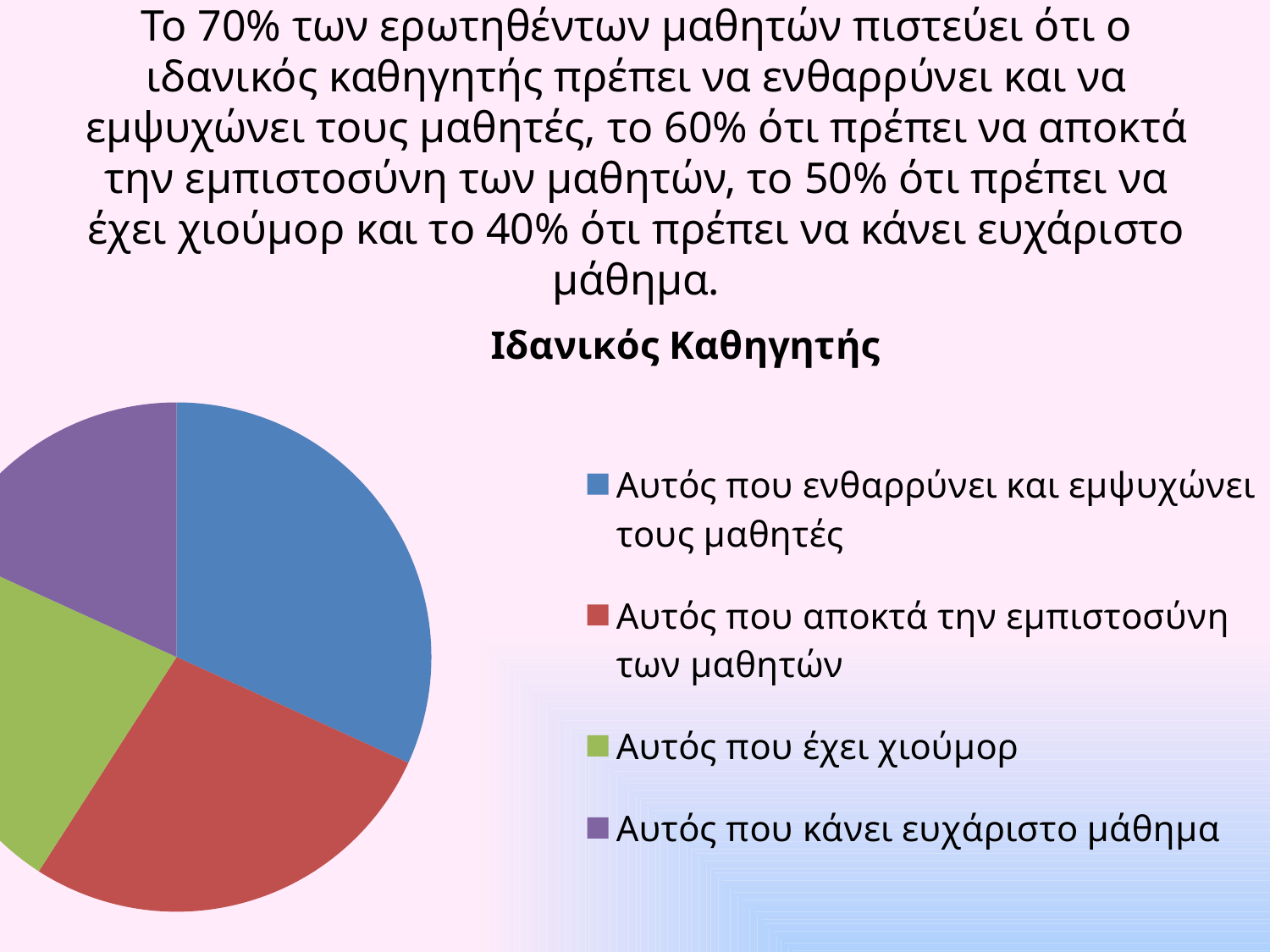
What is the title of the chart? Ιδανικός Καθηγητής How many entries does the legend list? 4 Which category has the largest slice of the pie? Αυτός που ενθαρρύνει και εμψυχώνει τους μαθητές What kind of chart is shown on the slide? pie chart Which category has the smallest slice of the pie? Αυτός που κάνει ευχάριστο μάθημα Which colour represents 'Αυτός που έχει χιούμορ' in the pie chart? green Which slice is larger: 'Αυτός που αποκτά την εμπιστοσύνη των μαθητών' or 'Αυτός που κάνει ευχάριστο μάθημα'? Αυτός που αποκτά την εμπιστοσύνη των μαθητών Which slice is larger: 'Αυτός που ενθαρρύνει και εμψυχώνει τους μαθητές' or 'Αυτός που έχει χιούμορ'? Αυτός που ενθαρρύνει και εμψυχώνει τους μαθητές How many slices does the pie chart have? 4